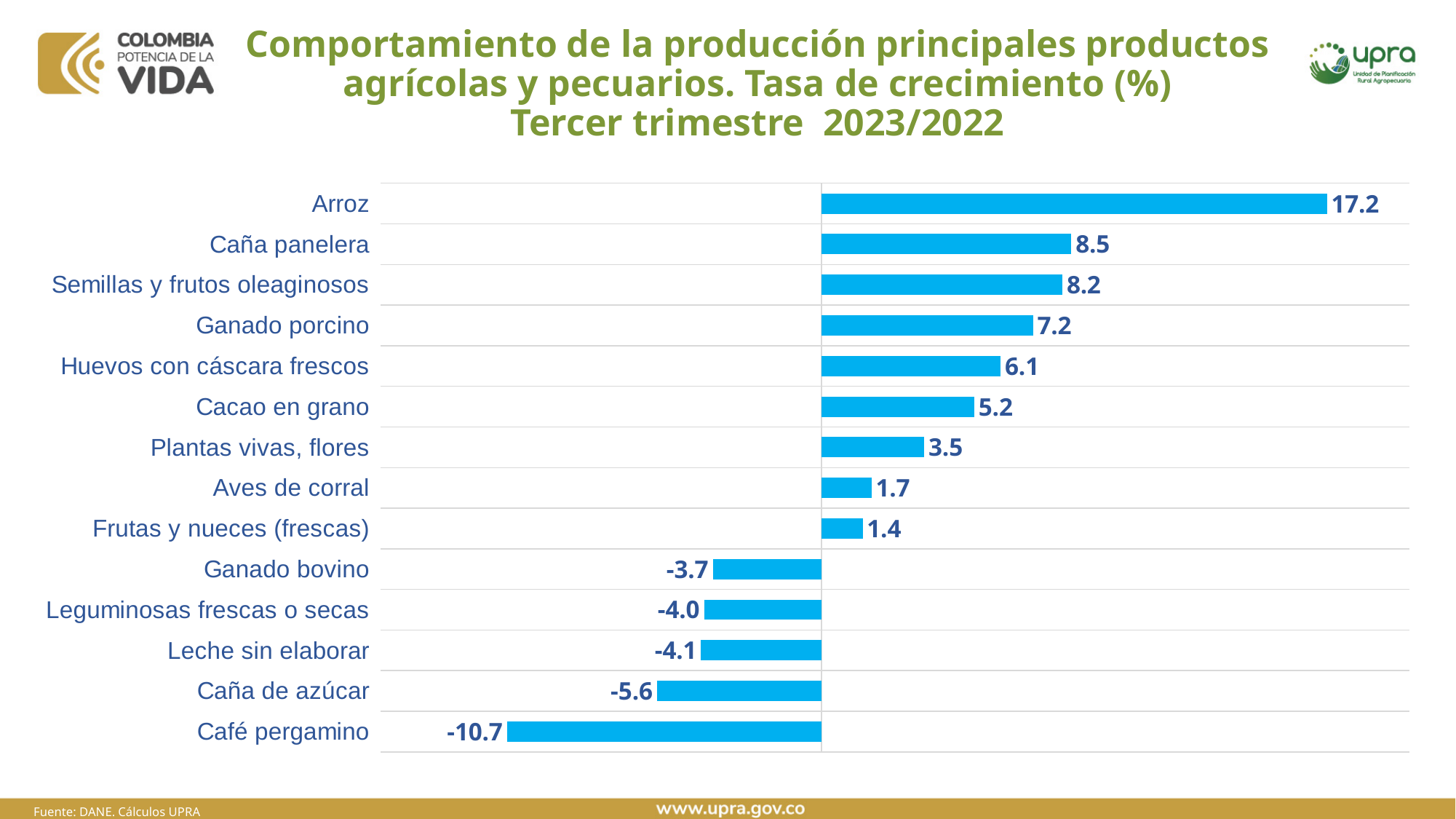
How many products show a negative growth rate? 5 Which has a larger value, Ganado porcino or Cacao en grano? Ganado porcino Which product has the highest growth rate? Arroz What is the value shown for Café pergamino? -10.7 What type of chart is shown on the slide? Bar chart What is the value shown for Leche sin elaborar? -4.1 What is the difference between the values for Arroz and Caña panelera? 8.7 What is the value shown for Huevos con cáscara frescos? 6.1 How many products are shown in the chart? 14 What is the growth rate shown for Arroz? 17.2 Which product has the lowest growth rate? Café pergamino What is the source cited at the bottom of the slide? DANE. Cálculos UPRA